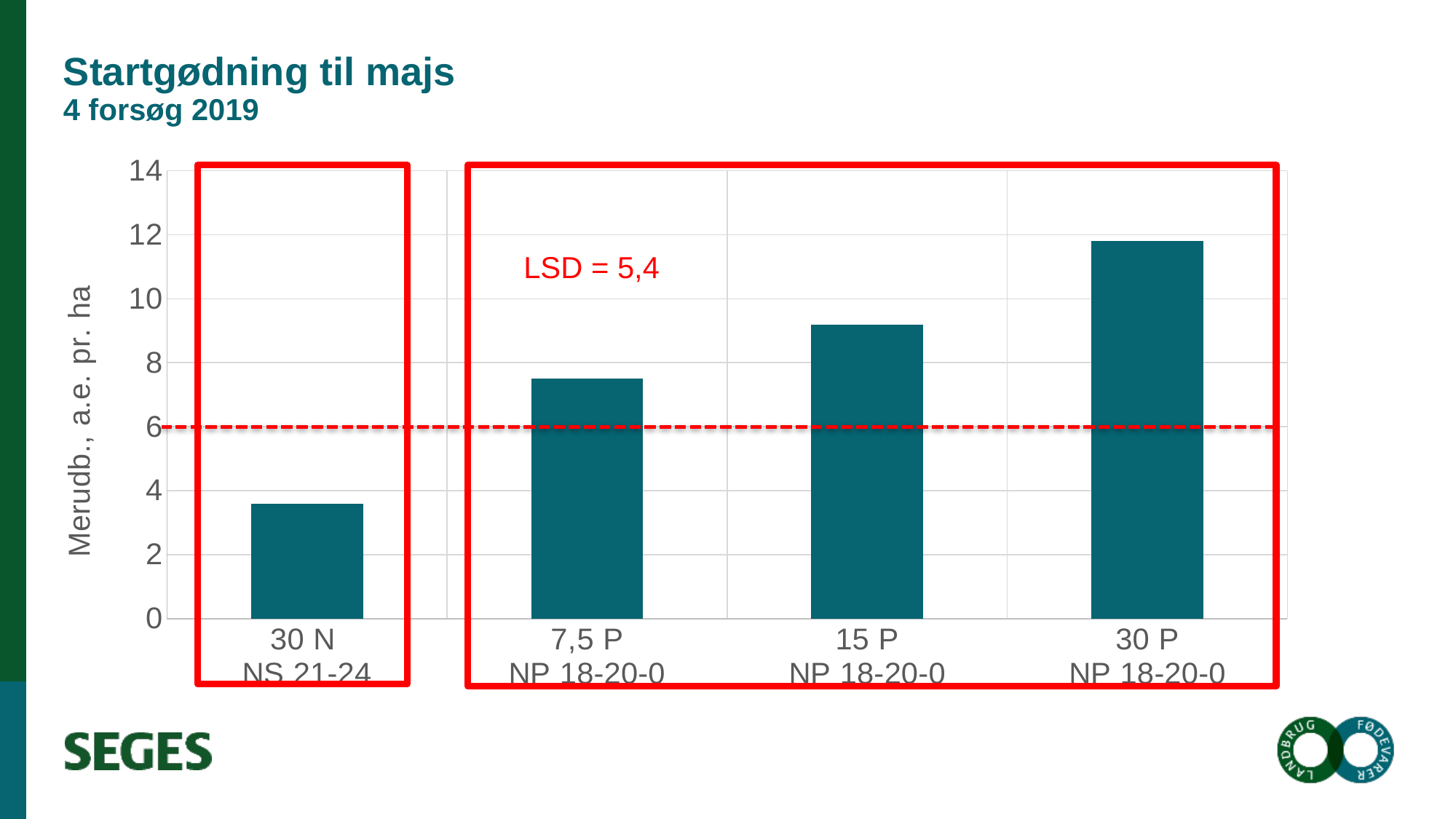
Do the values rise or fall from left to right across the categories? rise Is the value for 30 N NS 21-24 greater or less than 4? less Is the value for 30 P NP 18-20-0 greater or less than 10? greater Is the value for 7,5 P NP 18-20-0 greater or less than 6? greater What kind of chart is shown on the slide? bar chart Which category has the highest value in the chart? 30 P NP 18-20-0 What LSD value is annotated on the chart? LSD = 5,4 Which is larger, the value for 15 P NP 18-20-0 or the value for 7,5 P NP 18-20-0? 15 P NP 18-20-0 How many bars (categories) are plotted in the chart? 4 Which category has the lowest value in the chart? 30 N NS 21-24 What is the title of the chart on the slide? Startgødning til majs